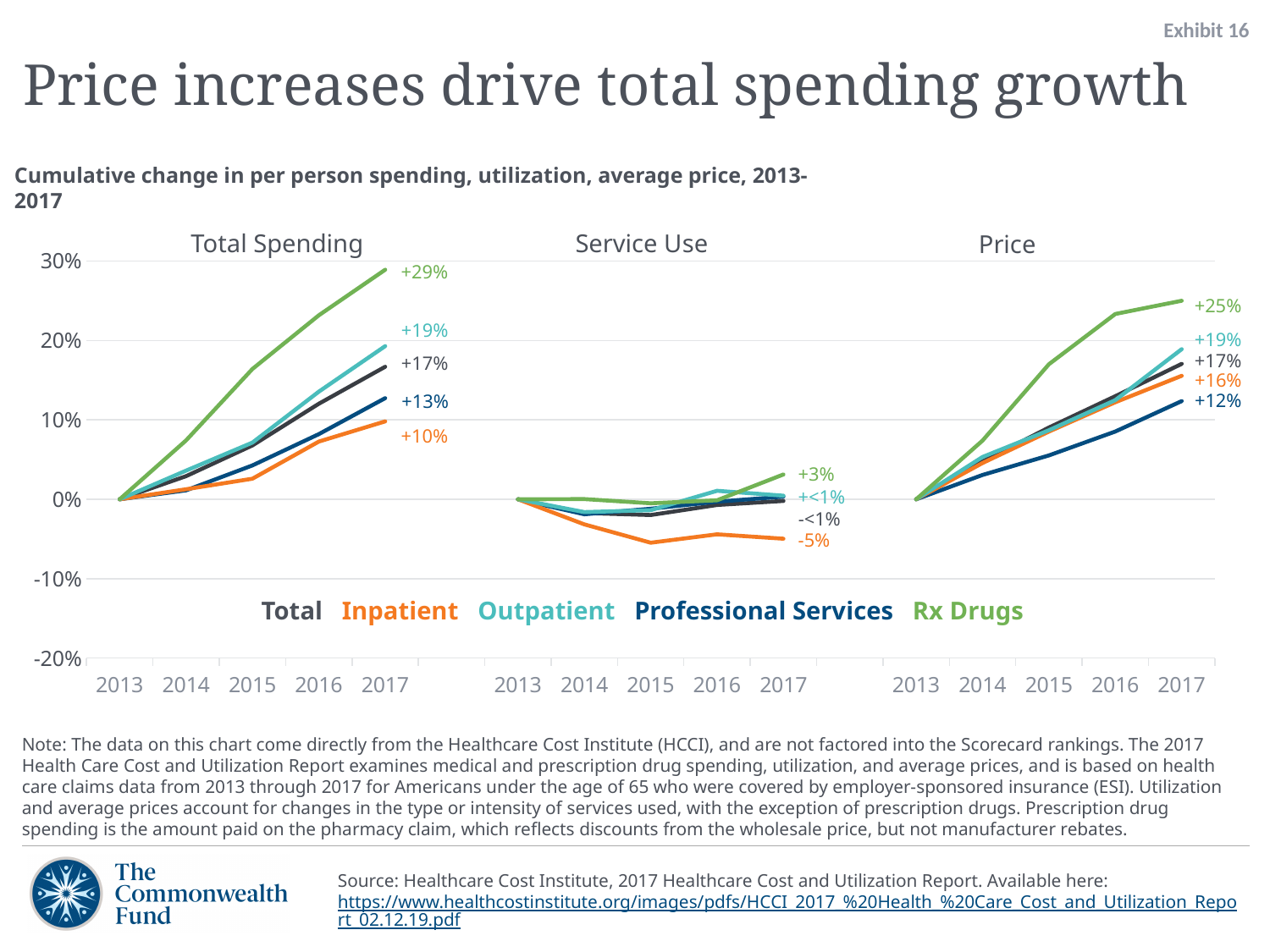
In the Price panel, which is larger in 2017: Outpatient or Professional Services? Outpatient How many years are shown on the x axis of each panel? 5 In the Total Spending panel, does the Rx Drugs line rise or fall from 2013 to 2017? Rise How many series does the legend list? 5 In the Price panel, which series has the highest cumulative change in 2017? Rx Drugs In the Price panel, what is the cumulative change for Inpatient by 2017? +16% In the Total Spending panel, what is the difference between the 2017 values for Rx Drugs and Inpatient? 19 percentage points In the Price panel, is the 2017 value for Rx Drugs greater or less than 20%? greater In the Total Spending panel, which series has the lowest cumulative change in 2017? Inpatient In the Total Spending panel, what is the cumulative change for Rx Drugs by 2017? +29% In the Service Use panel, what is the cumulative change for Inpatient by 2017? -5% What kind of chart is shown on the slide? Line chart